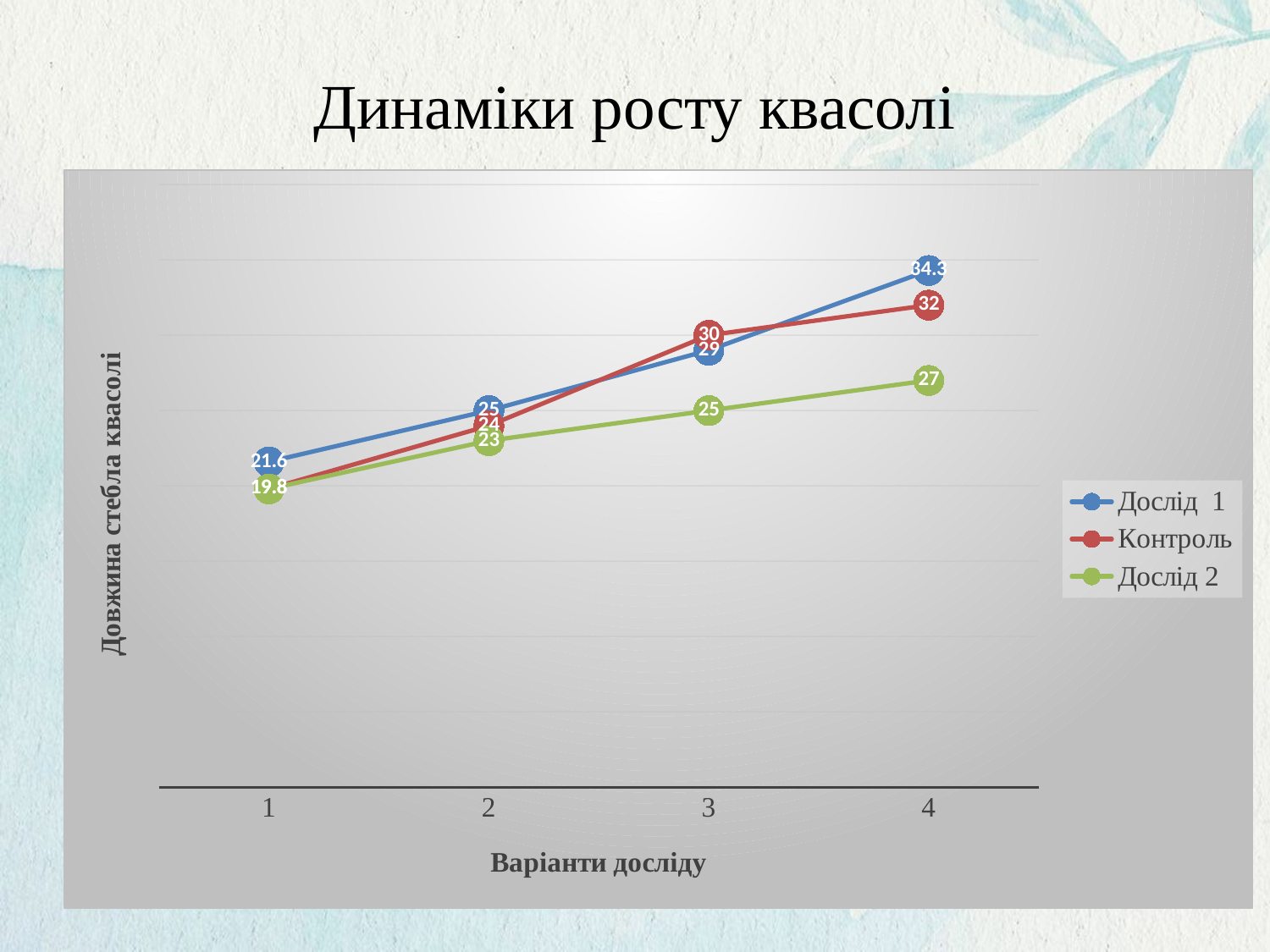
At variant 3, which is larger: Контроль or Дослід 1? Контроль What is the value of Дослід 2 at variant 1? 19.8 Do the values of Дослід 2 rise or fall from variant 1 to variant 4? rise Which series has the lowest value at variant 3? Дослід 2 What is the title of the chart on the slide? Динаміки росту квасолі Which series has the highest value at variant 4? Дослід 1 What type of chart is shown on the slide? line chart What is the value of Дослід 1 at variant 4? 34.3 What is the value of Контроль at variant 3? 30 How many series does the legend list? 3 What is the value of Дослід 1 at variant 2? 25 What is the difference between Дослід 1 and Дослід 2 at variant 4? 7.3